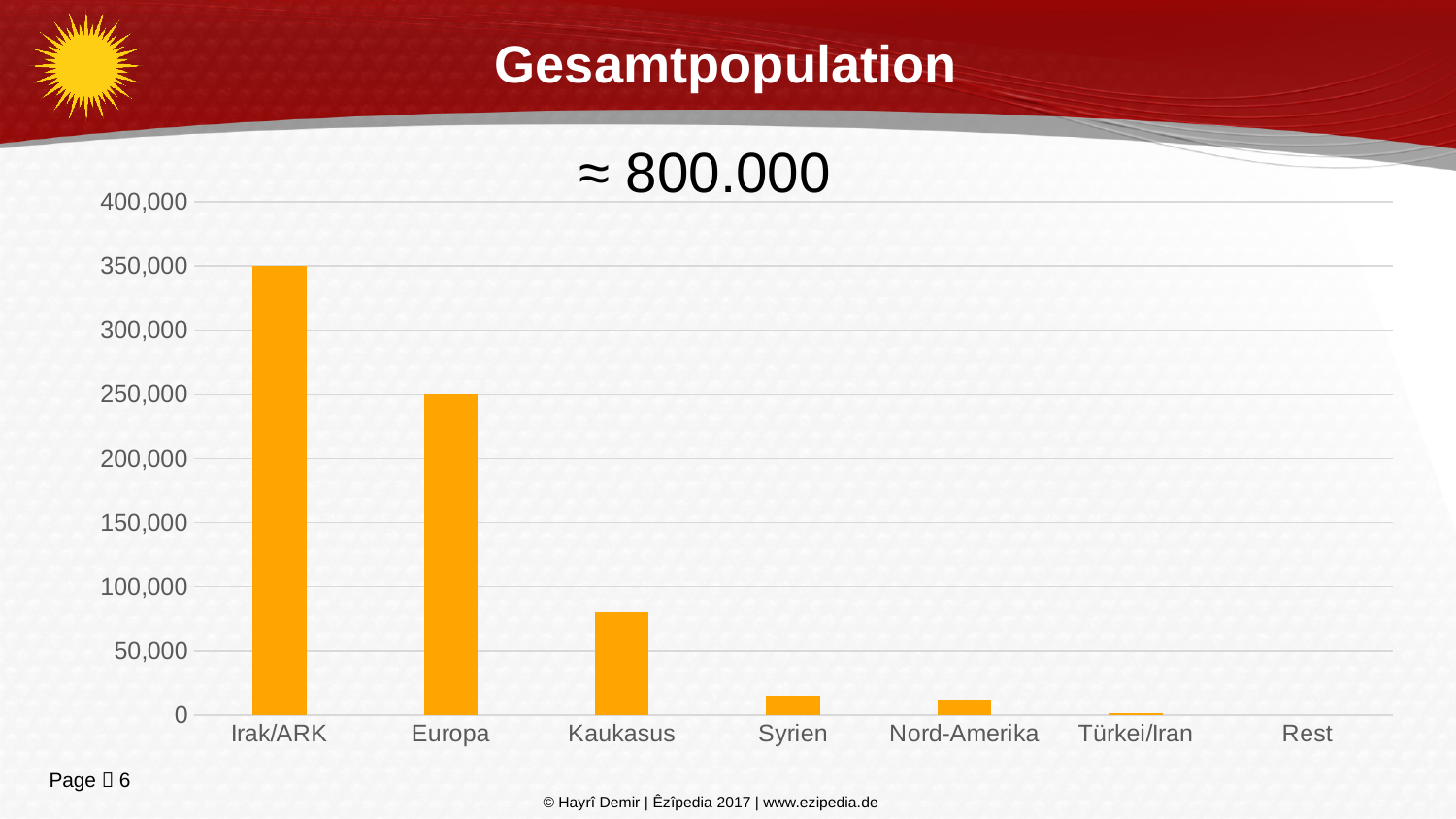
Is the value for Kaukasus greater or less than 100,000? less Is the value for Syrien greater or less than 50,000? less Which has a larger value, Europa or Kaukasus? Europa Is the value for Kaukasus greater or less than 50,000? greater What is the value for Europa? 250,000 What is the value for Irak/ARK? 350,000 What is the title of the chart on the slide? Gesamtpopulation What is the difference between the values for Irak/ARK and Europa? 100,000 How many categories are shown on the x axis of the chart? 7 What kind of chart is shown on the slide? bar chart Do the values rise or fall from left to right along the x axis? fall Which category has the highest value in the chart? Irak/ARK